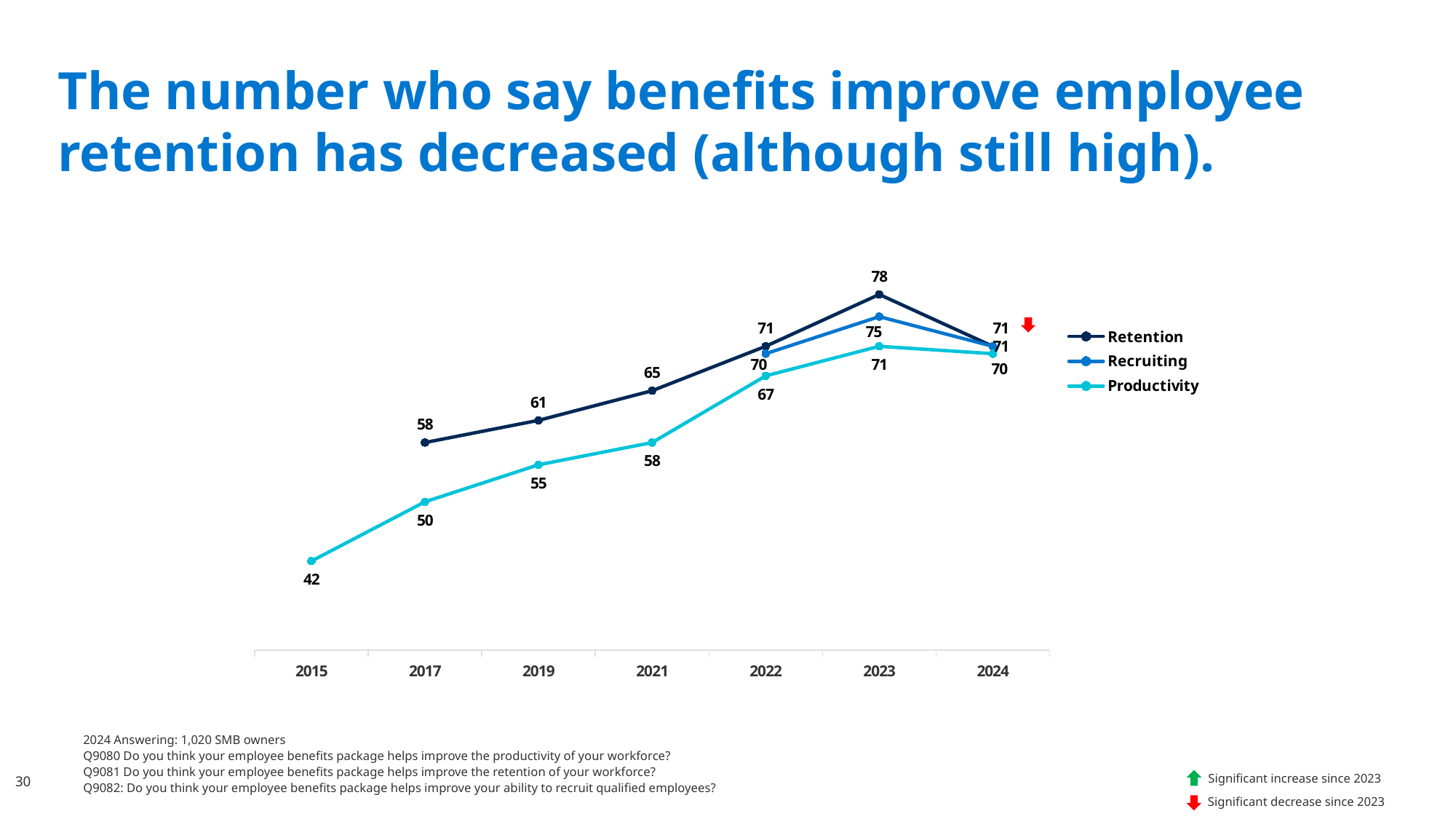
How many years are shown on the x axis? 7 How many series does the legend list? 3 By how much did the Retention value fall from 2023 to 2024? 7 Does the Productivity series rise or fall from 2015 to 2023? rise What is the Productivity value for 2015? 42 What is the Retention value for 2023? 78 In which year is the Retention series at its highest? 2023 What kind of chart is shown on the slide? line chart In 2022, which is larger: the Retention value or the Productivity value? Retention What does the red downward arrow next to the 2024 Retention value indicate? Significant decrease since 2023 What is the Recruiting value for 2023? 75 In which year is the Productivity series at its lowest? 2015